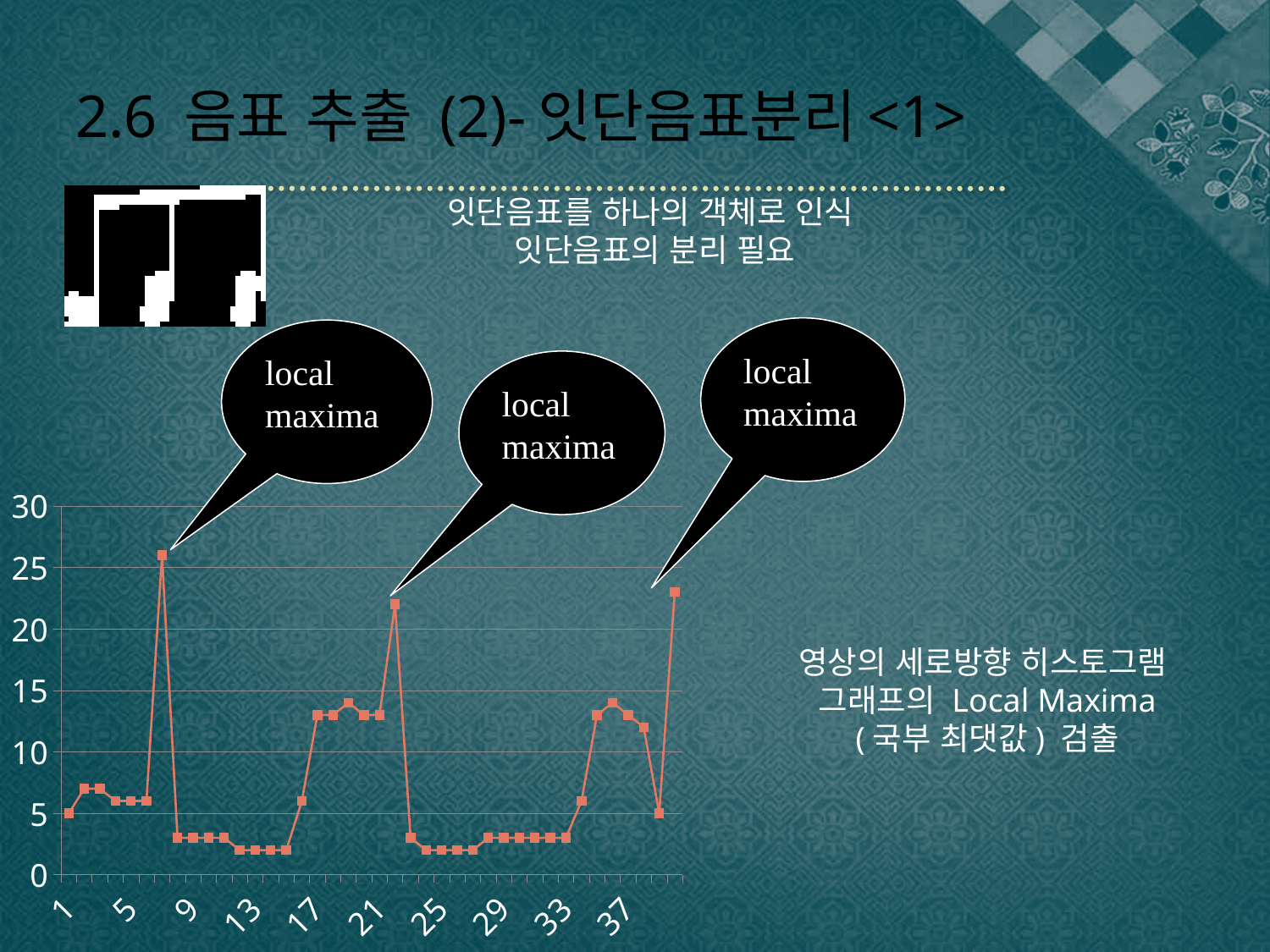
What is the highest value shown on the y axis? 30 At which x-axis position does the line reach its highest value? 7 Is the value at x = 17 greater or less than 10? greater Which is larger, the value at x = 1 or the value at x = 17? x = 17 Is the value at x = 13 greater or less than 5? less Is the value at x = 1 greater or less than 10? less Do the values rise or fall between x = 13 and x = 17? rise How many callouts labelled 'local maxima' point to the chart? 3 Which is larger, the value at x = 7 or the value at x = 21? x = 7 What kind of chart is shown on the slide? line chart